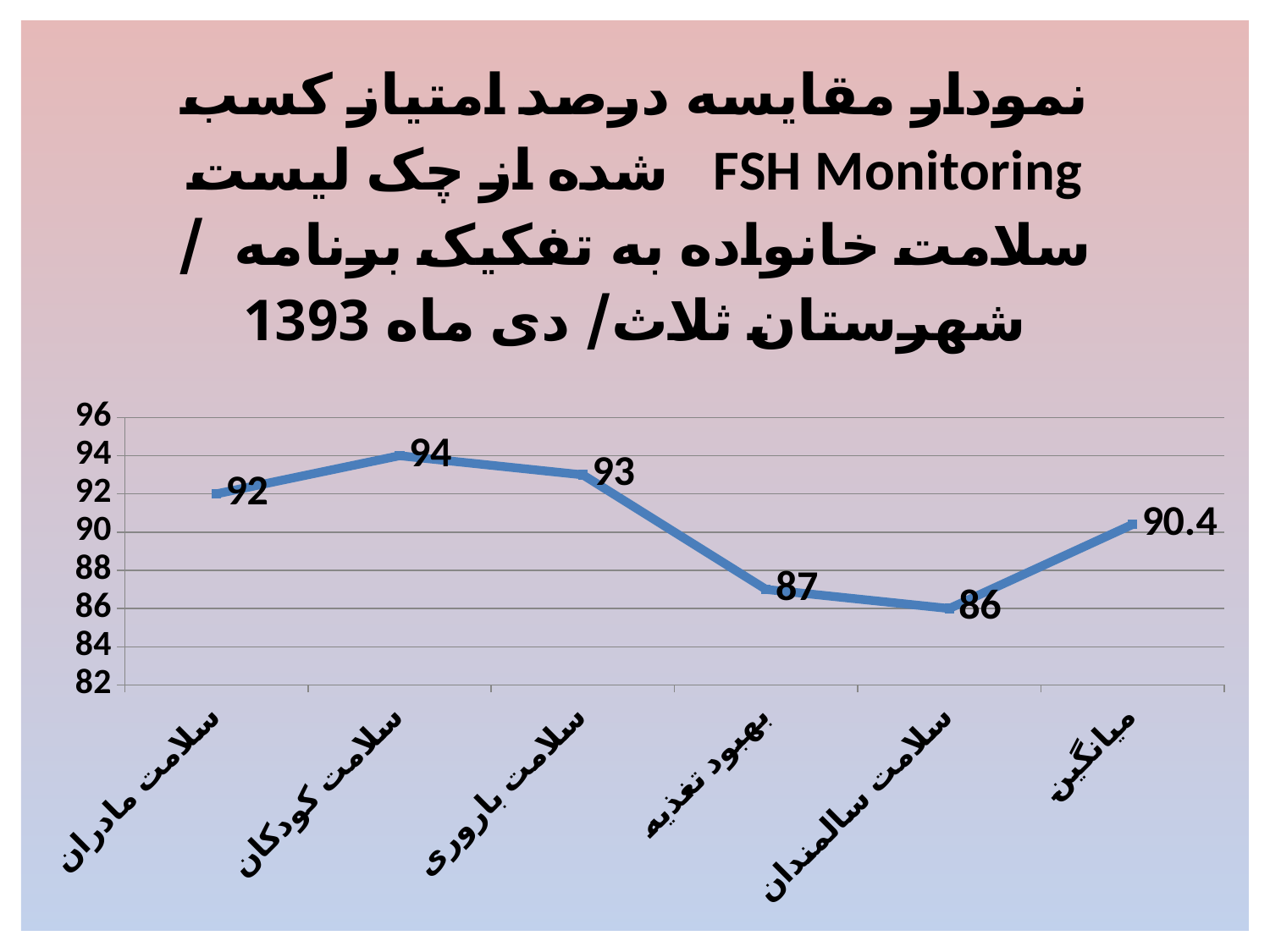
What is the difference between the values for سلامت کودکان and سلامت سالمندان? 8 Which category has the lowest value? سلامت سالمندان What is the value for میانگین? 90.4 Do the values rise or fall from سلامت باروری to سلامت سالمندان? fall What is the value for بهبود تغذیه? 87 Which is larger, the value for سلامت باروری or the value for بهبود تغذیه? سلامت باروری What kind of chart is shown on the slide? line chart Is the value for سلامت سالمندان greater or less than 88? less What is the value for سلامت مادران? 92 Which category has the highest value? سلامت کودکان How many categories are shown on the x axis? 6 What is the value for سلامت کودکان? 94